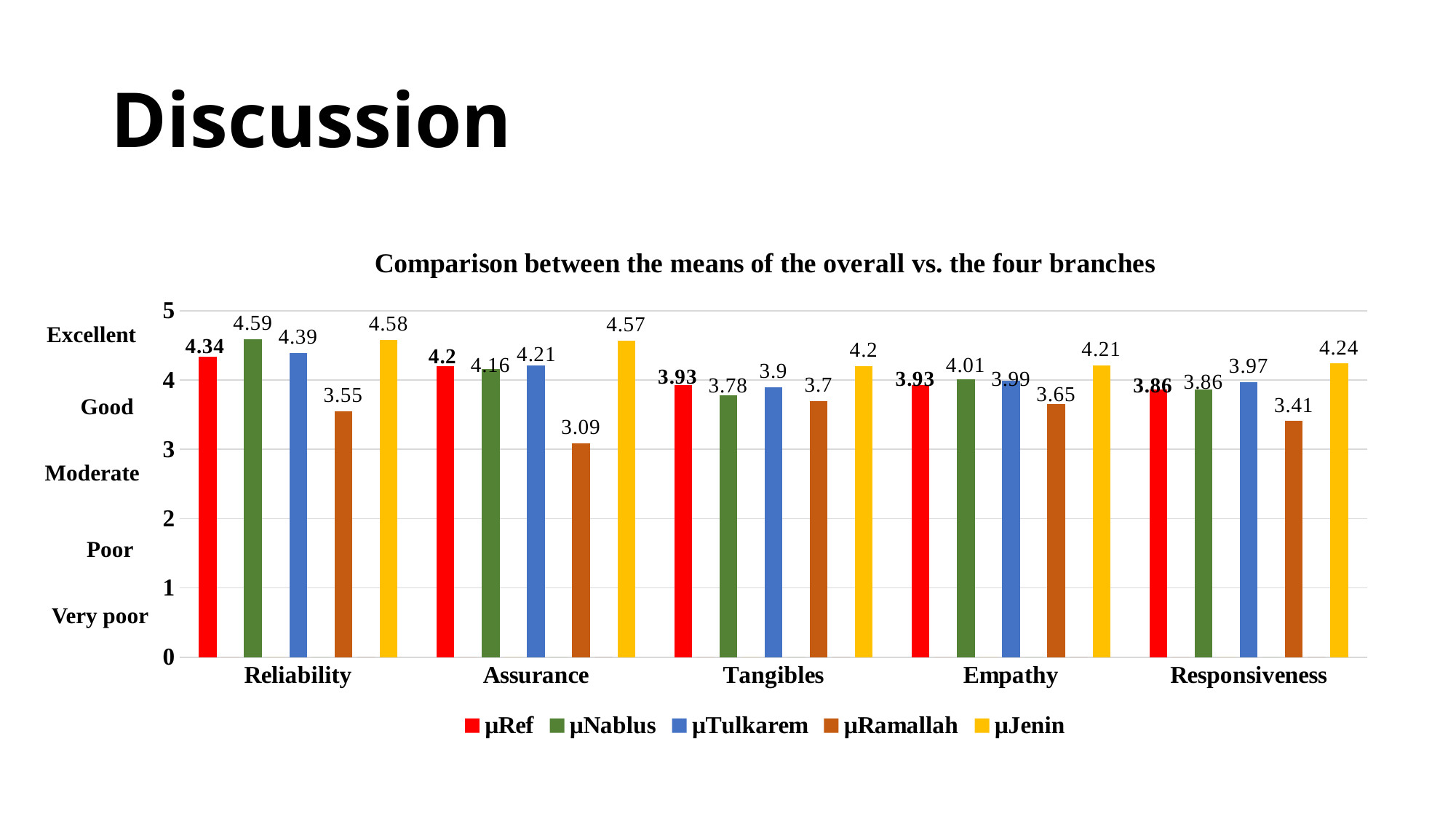
What is the μJenin value for Responsiveness? 4.24 What type of chart is shown on the slide? bar chart What is the difference between the μJenin and μRamallah values for Assurance? 1.48 Which series has the highest value for Empathy? μJenin What is the μRamallah value for Assurance? 3.09 What is the μRef value for Tangibles? 3.93 Is the μRamallah value for Responsiveness greater or less than 4? less Which is larger for Tangibles, μTulkarem or μNablus? μTulkarem How many series does the legend list? 5 Which branch has the lowest value for Reliability? μRamallah What is the μNablus value for Reliability? 4.59 How many categories are shown on the x axis? 5